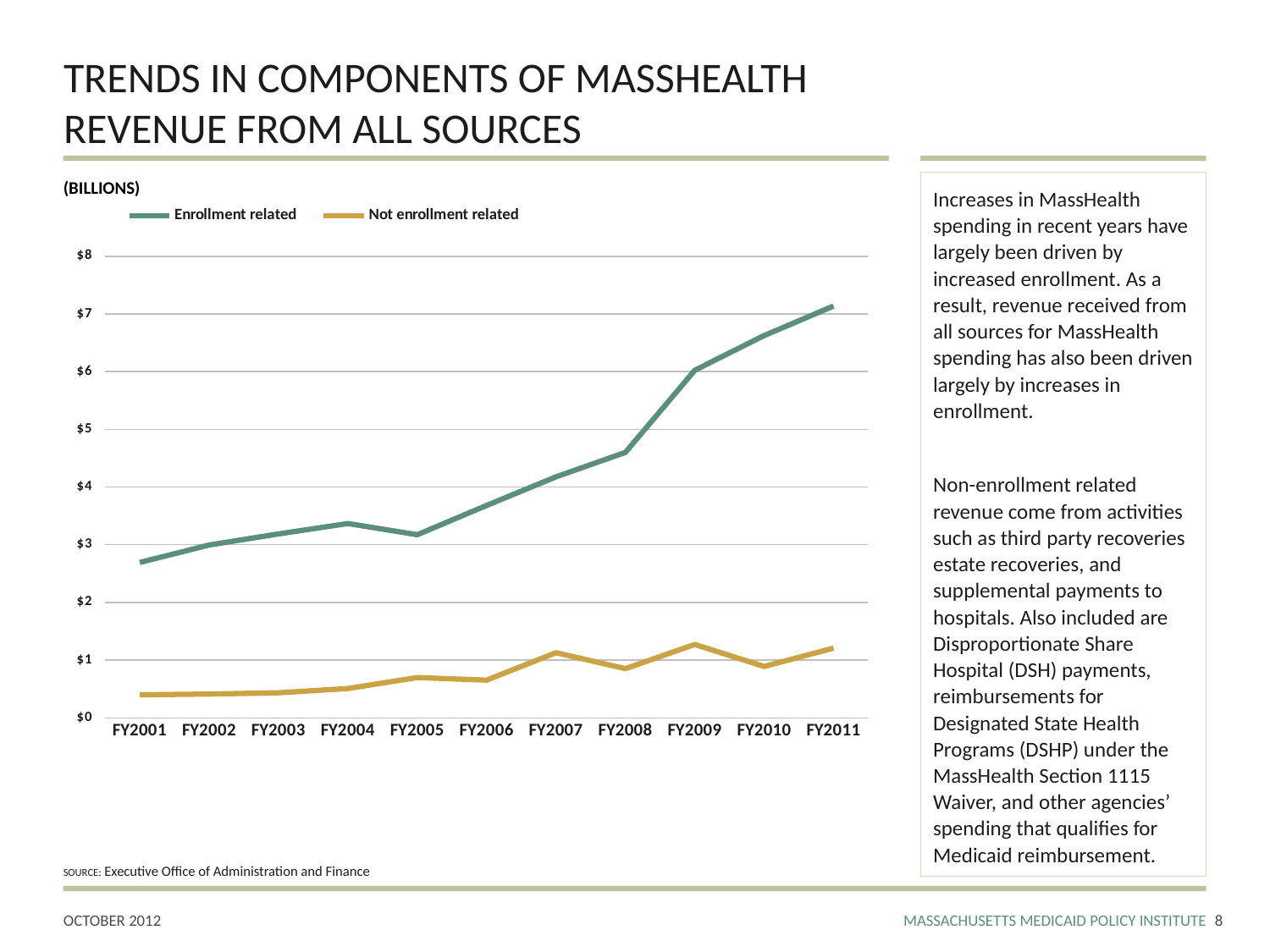
How many fiscal years are plotted along the x axis? 11 Is the Enrollment related value for FY2011 greater or less than $6? greater Is the Not enrollment related value for FY2009 greater or less than $1? greater Is the Not enrollment related value for FY2001 greater or less than $1? less What unit is stated above the chart for the values on the y axis? (BILLIONS) What kind of chart is shown on the slide? line chart How many series does the legend list? 2 Does the Enrollment related series generally rise or fall from FY2001 to FY2011? rise Which fiscal year has the lowest value for the Enrollment related series? FY2001 In FY2011, which series has the larger value, Enrollment related or Not enrollment related? Enrollment related Which fiscal year has the highest value for the Enrollment related series? FY2011